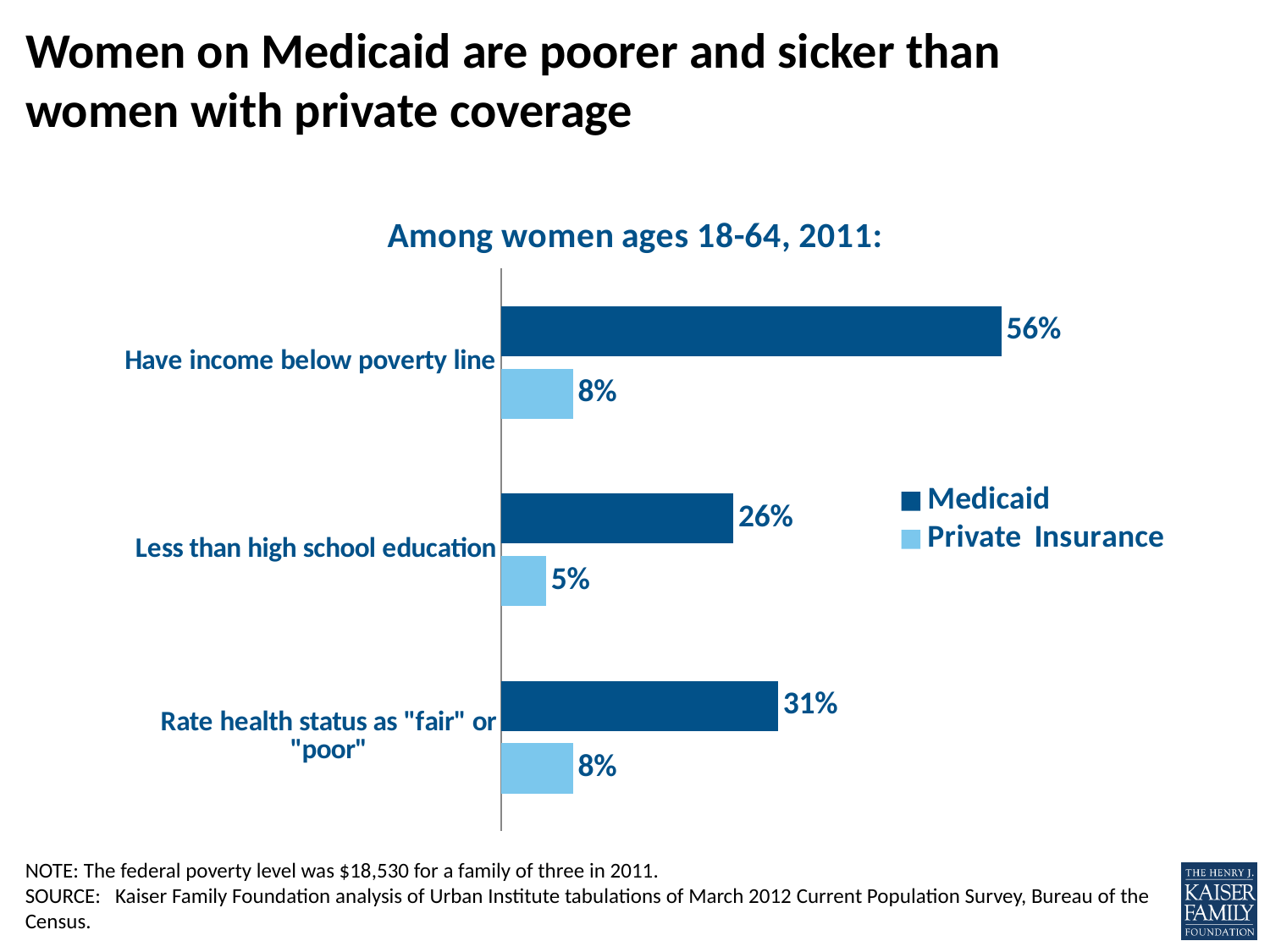
What kind of chart is shown on the slide? Bar chart For which category is the Medicaid value highest? Have income below poverty line What percentage of women with private insurance have income below the poverty line? 8% How many categories are shown on the chart? 3 What percentage of women on Medicaid rate their health status as "fair" or "poor"? 31% What percentage of women with private insurance have less than a high school education? 5% How many series does the legend list? 2 For which category is the Private Insurance value lowest? Less than high school education What is the difference between the Medicaid and Private Insurance values for having income below the poverty line? 48 percentage points What percentage of women on Medicaid have income below the poverty line? 56% What is the difference between the Medicaid and Private Insurance values for rating health status as "fair" or "poor"? 23 percentage points Which is larger: the Medicaid value for less than high school education or the Medicaid value for rating health status as "fair" or "poor"? Rate health status as "fair" or "poor"